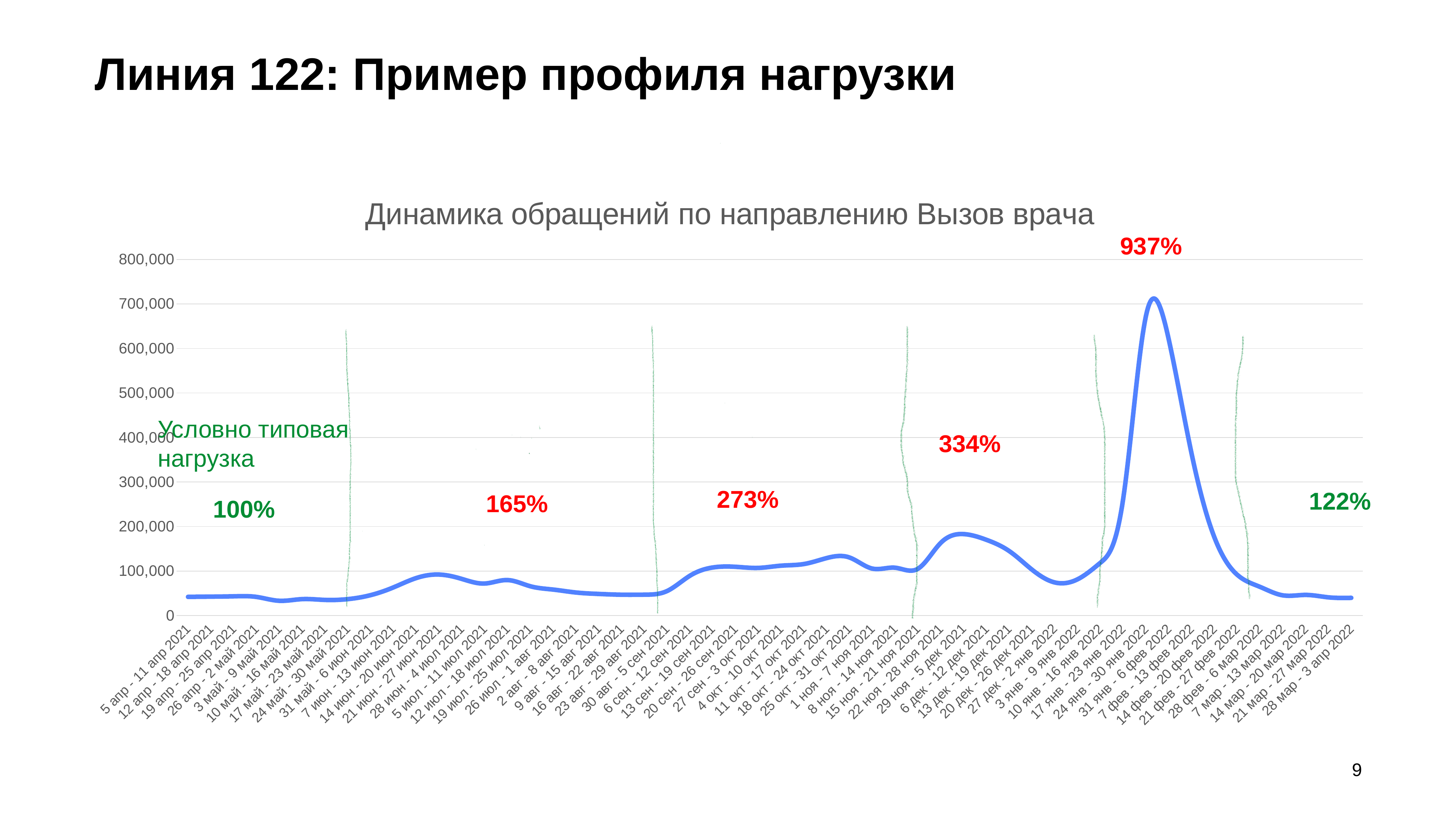
What is the title of the chart? Динамика обращений по направлению Вызов врача What is the highest value shown on the vertical axis? 800,000 What percentage label is shown in green in the first segment of the chart, under the text 'Условно типовая нагрузка'? 100% Is the value for 28 мар - 3 апр 2022 greater or less than 100,000? less What percentage label is shown in red above the highest peak of the line? 937% Which annotated percentage is larger, 334% or 273%? 334% What kind of chart is shown on the slide? line chart What percentage label is shown in green at the far right of the chart? 122% Is the peak value of the line greater or less than 600,000? greater How many percentage labels are annotated on the chart? 6 What is the difference between the highest annotated percentage (937%) and the baseline 100%? 837% Is the value for 5 апр - 11 апр 2021 greater or less than 100,000? less